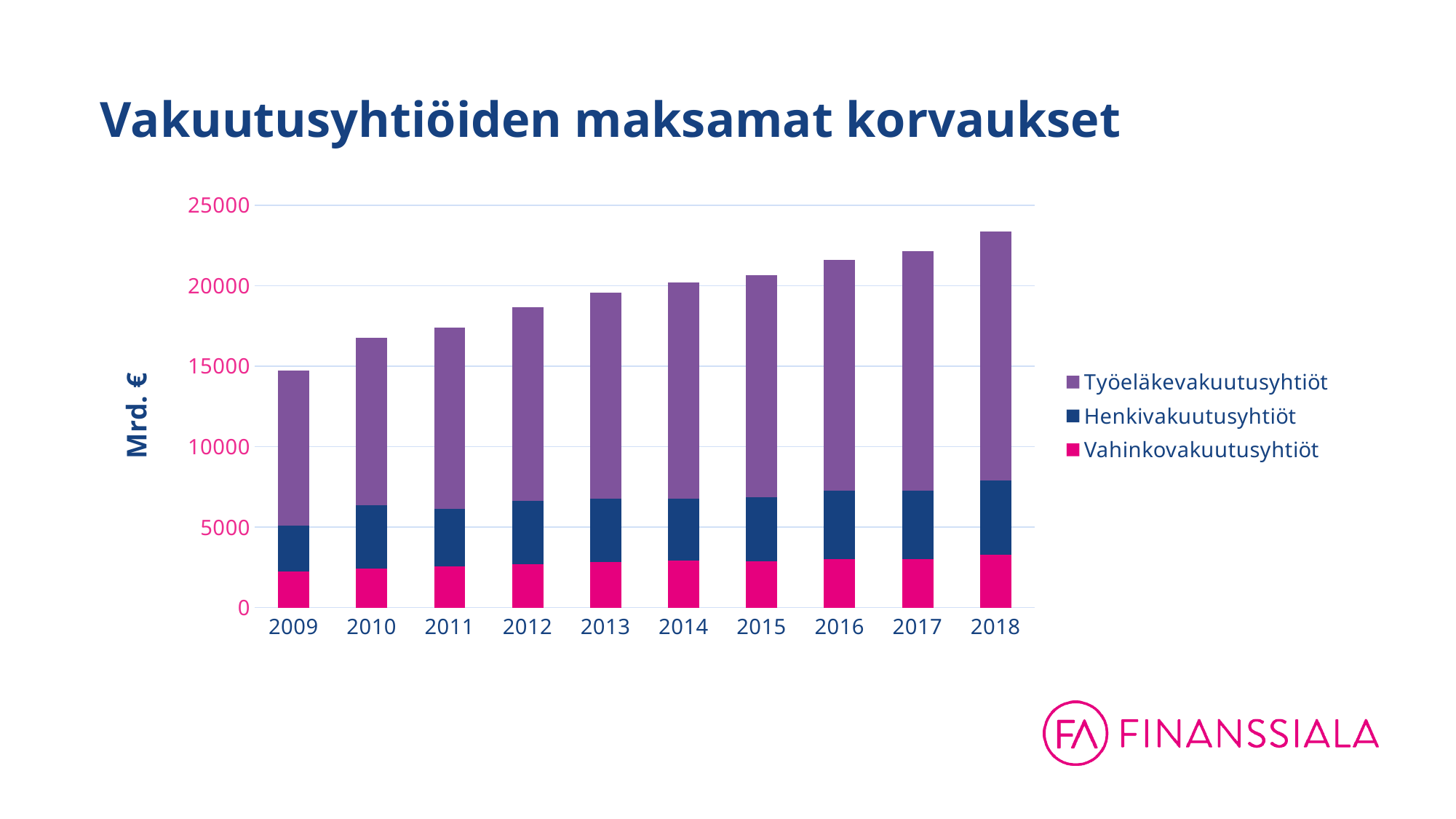
What kind of chart is shown on the slide? stacked bar chart Is the Vahinkovakuutusyhtiöt segment for 2018 greater or less than 5000? less Which is larger, the total bar for 2018 or the total bar for 2009? 2018 Is the total bar for 2009 greater or less than 10000? greater Which year has the shortest total bar? 2009 How many years are shown on the x axis of the chart? 10 What is the title of the chart? Vakuutusyhtiöiden maksamat korvaukset What is the label on the vertical axis of the chart? Mrd. € Is the total bar for 2018 greater or less than 20000? greater How many series does the legend list? 3 Which year has the tallest total bar? 2018 Do the total bar heights rise or fall from 2009 to 2018? rise